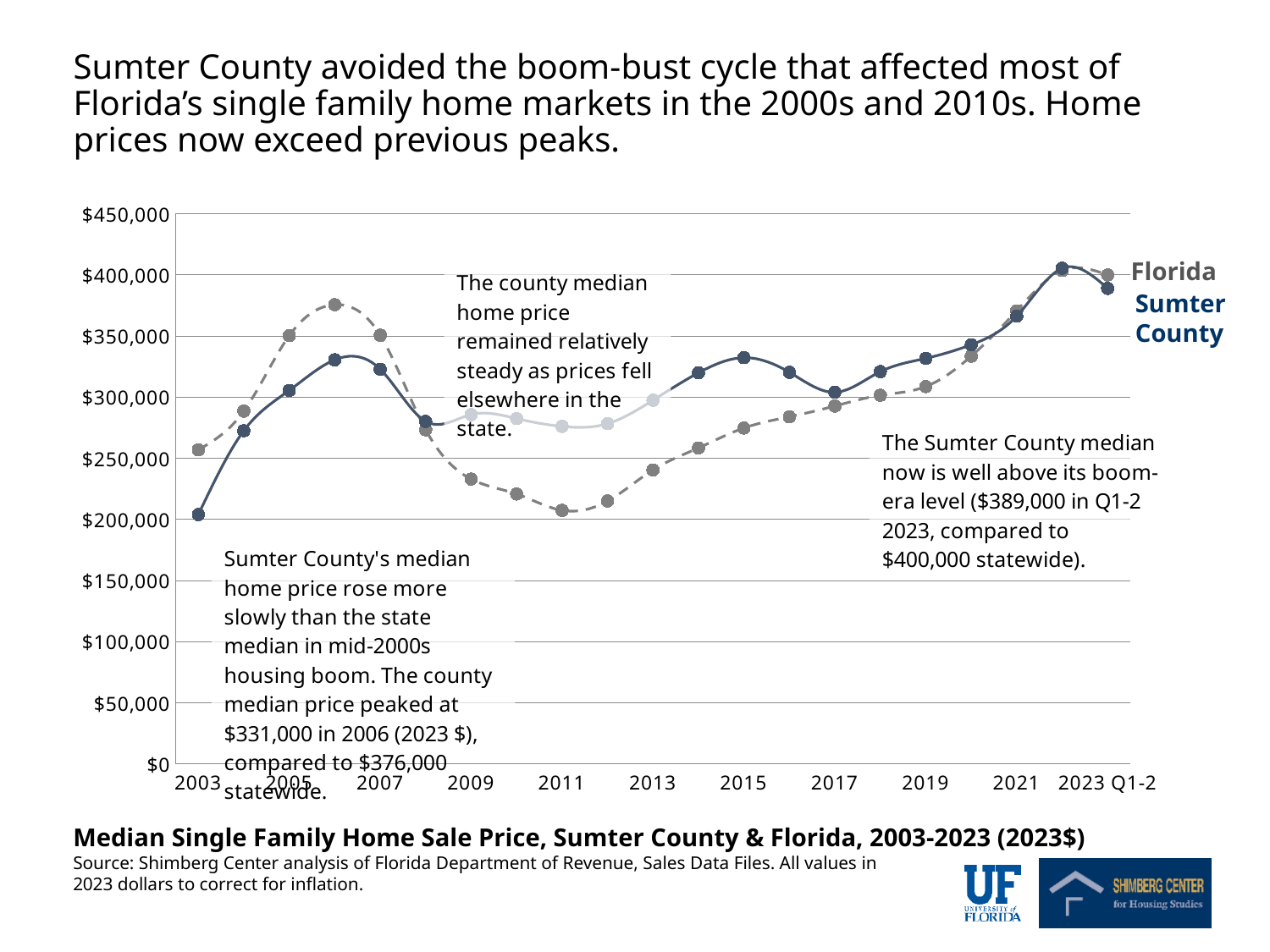
According to the annotation, what was the statewide median price in 2006 when Sumter County peaked? $376,000 What kind of chart is shown on the slide? line chart Is the Sumter County value for 2003 greater or less than $250,000? less According to the annotation, at what value did the Sumter County median price peak in 2006? $331,000 According to the annotation, what is the Sumter County median in Q1-2 2023? $389,000 Which series is drawn with a dashed line, Florida or Sumter County? Florida How many series does the chart plot? 2 What is the title of the chart? Median Single Family Home Sale Price, Sumter County & Florida, 2003-2023 (2023$) In 2011, which series has the higher median price, Florida or Sumter County? Sumter County In 2006, which series has the higher median price, Florida or Sumter County? Florida What is the difference between the 2006 statewide peak ($376,000) and the Sumter County peak ($331,000)? $45,000 Does the Florida median price rise or fall between 2006 and 2011? fall